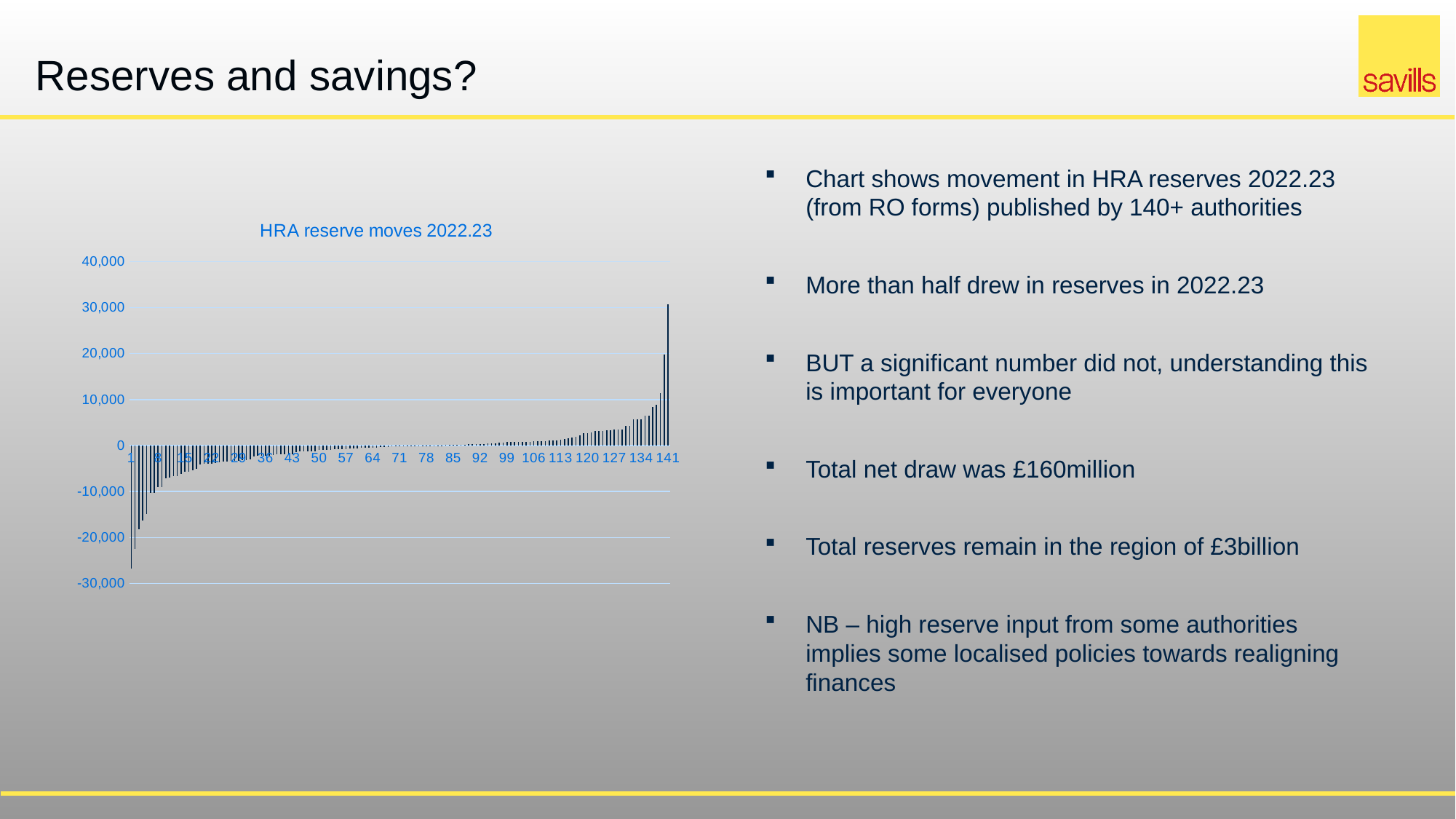
Which category has the lowest value, the first bar or the last bar? the first bar Do the bar values rise or fall moving from left to right along the x axis? rise What kind of chart is shown on the slide? bar chart Is the value for category 71 greater or less than 10,000? less Is the value for category 1 greater or less than -20,000? less Is the value for category 134 greater or less than 0? greater Which has the larger value, category 1 or category 141? 141 What is the title of the chart? HRA reserve moves 2022.23 What is the highest value labelled on the y axis? 40,000